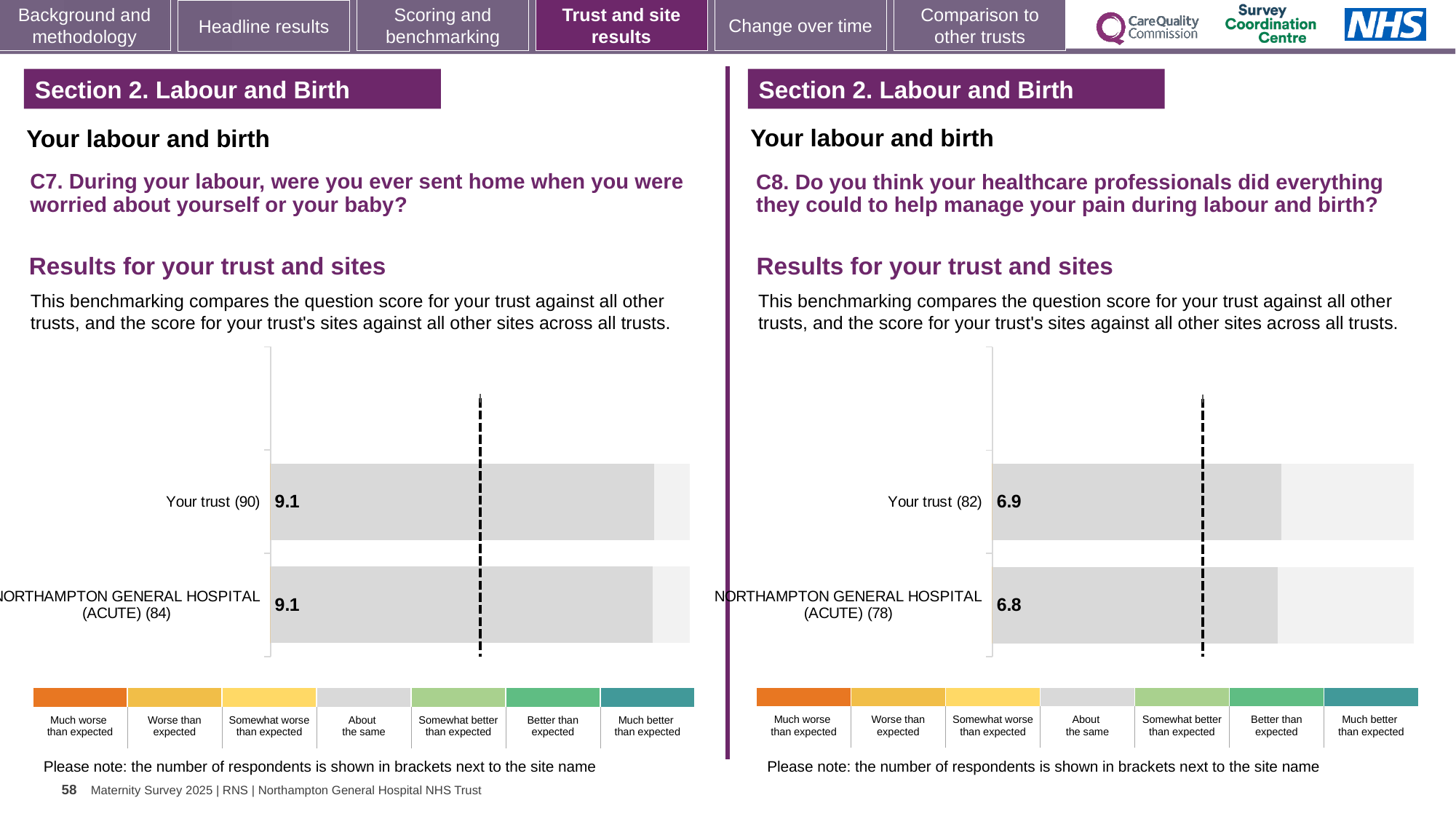
How many bars are plotted in the right chart (C8)? 2 In the left chart (C7), what is the score for Your trust? 9.1 In the left chart (C7), what is the score for Northampton General Hospital (Acute)? 9.1 In the right chart (C8), how many respondents are shown in brackets for Northampton General Hospital (Acute)? 78 How many categories does the colour key below the right chart (C8) list? 7 In the right chart (C8), what is the score for Northampton General Hospital (Acute)? 6.8 In the left chart (C7), what is the difference between the score for Your trust and the score for Northampton General Hospital (Acute)? 0 In the right chart (C8), what is the score for Your trust? 6.9 What kind of chart is used for the C7 results on the left? Bar chart In the right chart (C8), what is the difference between the score for Your trust and the score for Northampton General Hospital (Acute)? 0.1 How many bars are plotted in the left chart (C7)? 2 In the left chart (C7), how many respondents are shown in brackets for Your trust? 90